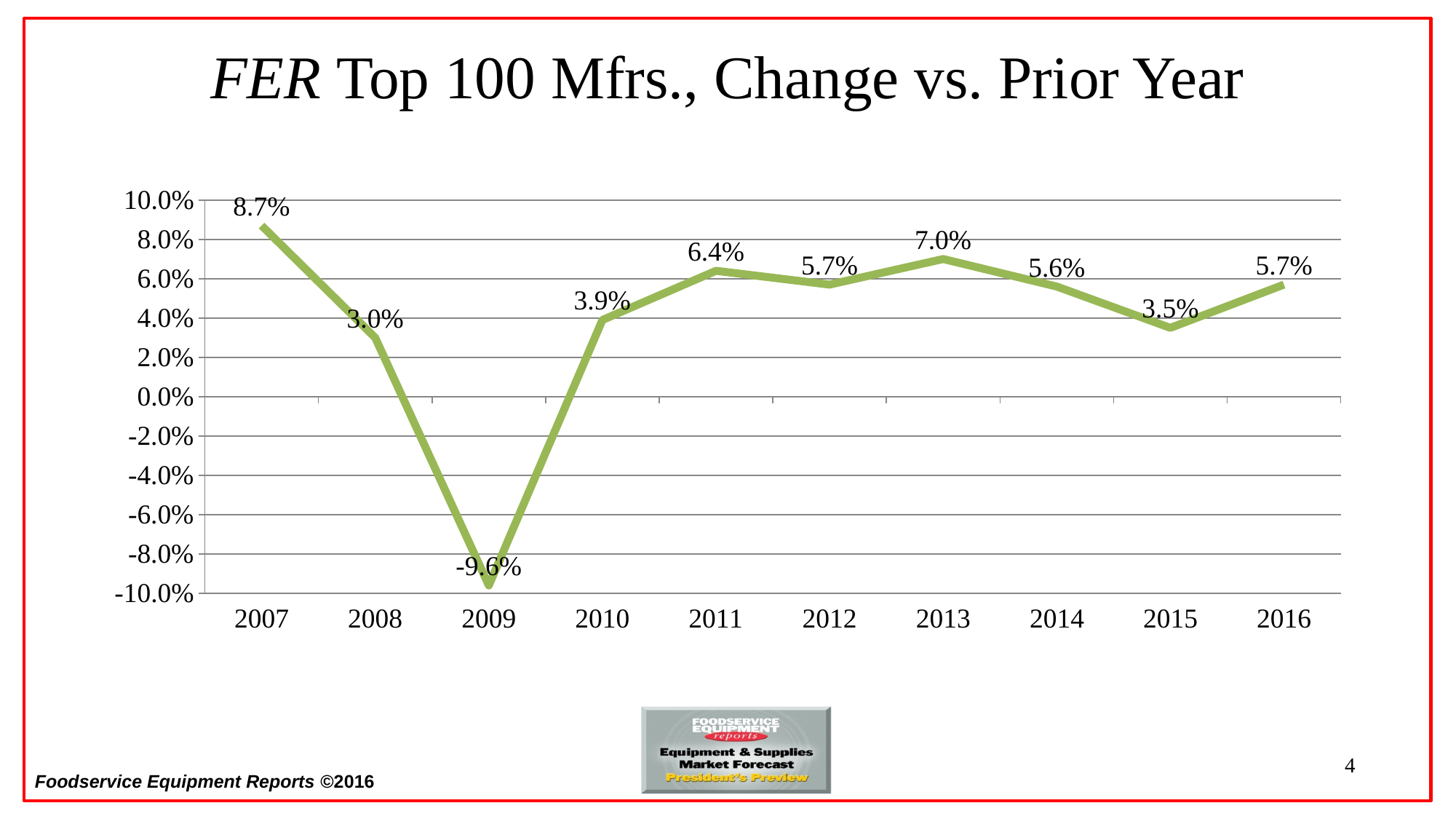
What is the change vs. prior year for 2013? 7.0% What kind of chart is shown on the slide? Line chart What is the title of the chart? FER Top 100 Mfrs., Change vs. Prior Year What is the change vs. prior year for 2009? -9.6% Which year has the highest change vs. prior year? 2007 Which year has the larger value, 2011 or 2015? 2011 What is the difference between the 2007 value and the 2008 value? 5.7 percentage points What is the change vs. prior year for 2016? 5.7% Which year has the lowest change vs. prior year? 2009 How many years are plotted on the chart? 10 Does the value rise or fall from 2015 to 2016? Rise Is the value for 2010 greater or less than 4.0%? less